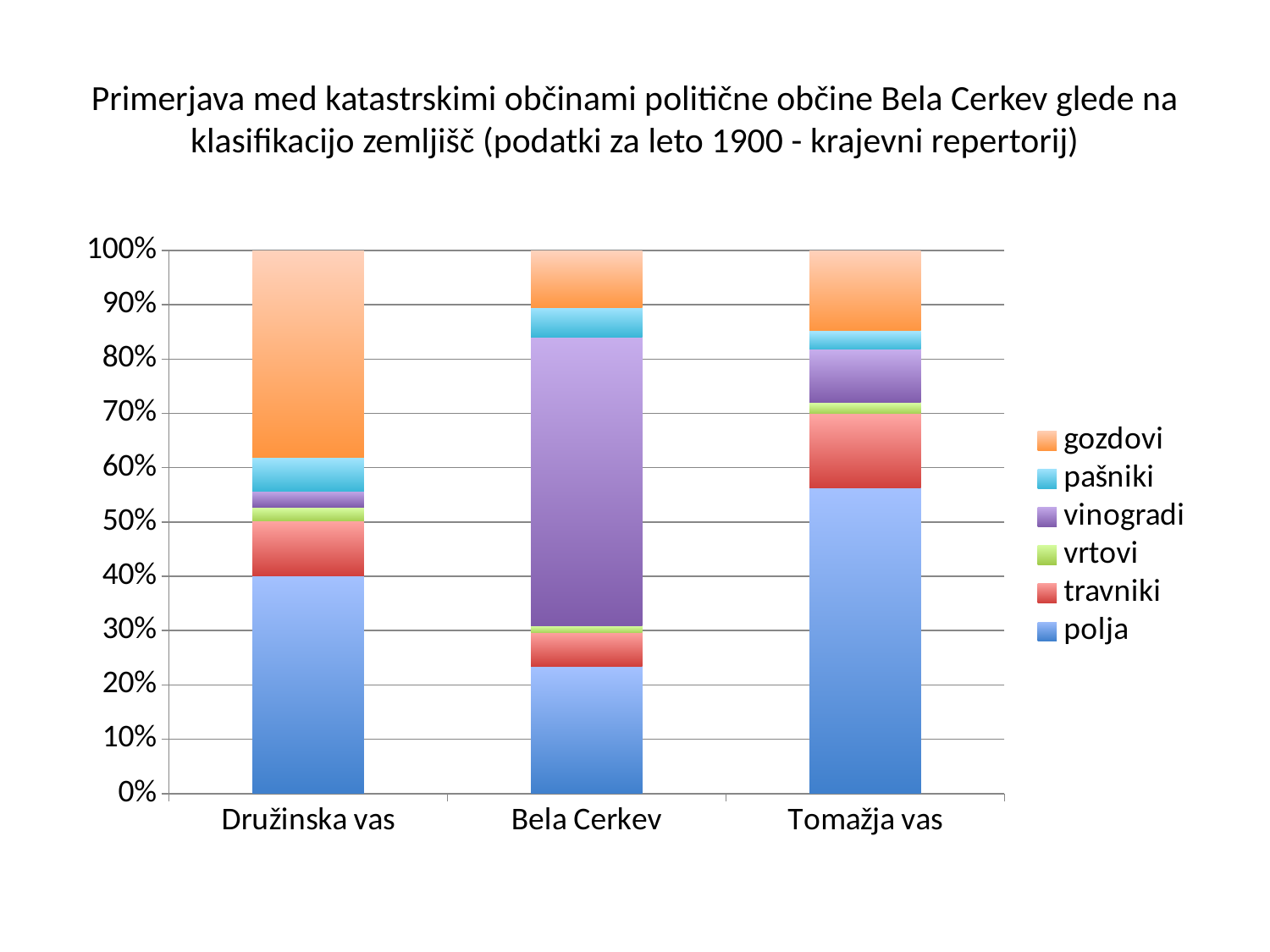
Which has a larger share of polja, Družinska vas or Bela Cerkev? Družinska vas Which municipality has the largest share of gozdovi? Družinska vas Which municipality has the largest share of polja? Tomažja vas Is the share of polja for Tomažja vas greater or less than 50%? greater How many series does the legend list? 6 What kind of chart is shown on the slide? stacked bar chart What is the total of each stacked bar? 100% Which municipality has the largest share of vinogradi? Bela Cerkev How many cadastral municipalities (categories) are shown on the x axis? 3 Which municipality has the smallest share of polja? Bela Cerkev Is the share of polja for Bela Cerkev greater or less than 30%? less Which series is listed first (at the top) in the legend? gozdovi